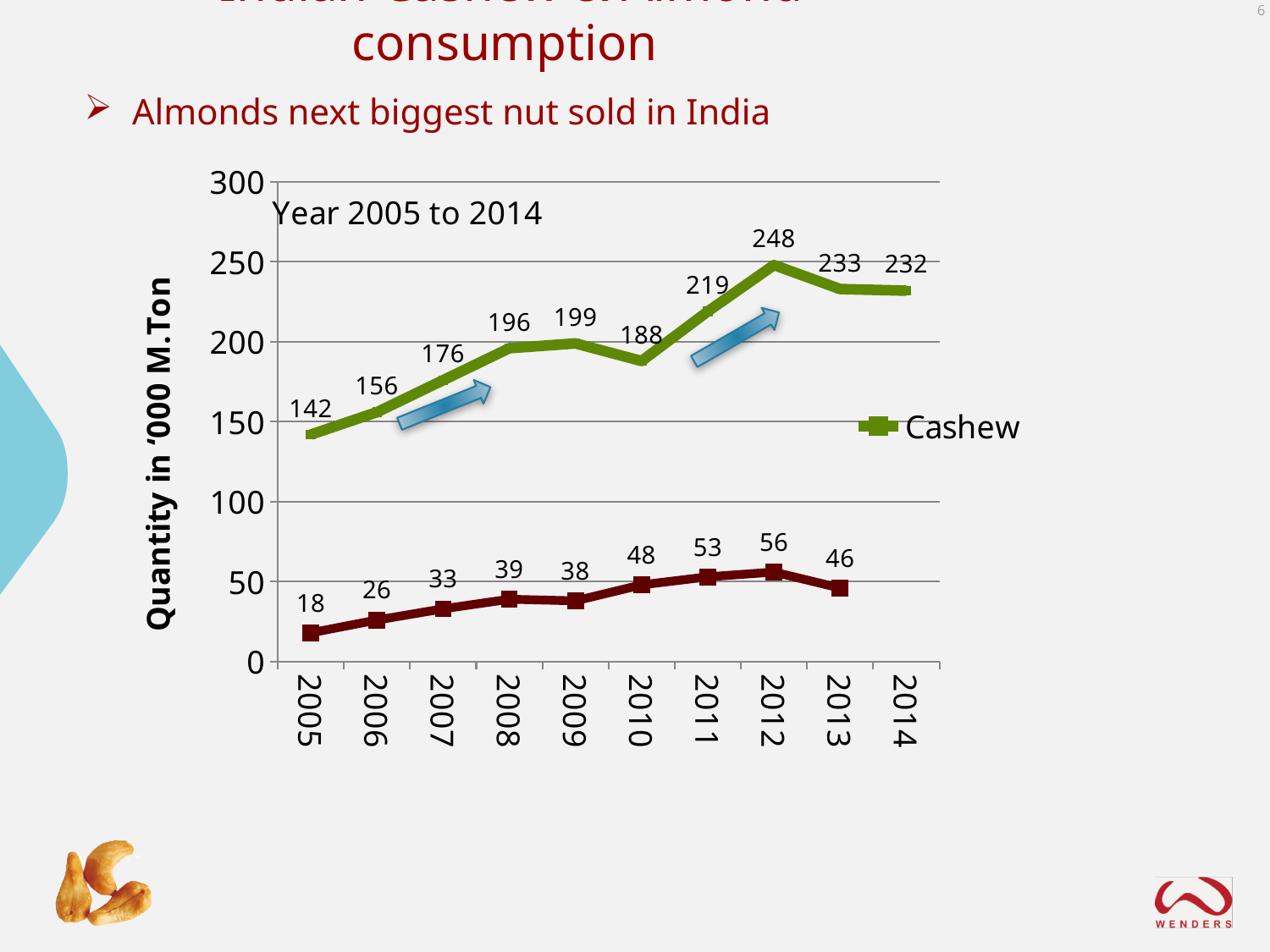
Which is larger, the Cashew value for 2008 or for 2009? 2009 What is the Cashew value for 2005? 142 In which year is the Cashew value highest? 2012 What kind of chart is shown on the slide? Line chart What is the Cashew value for 2012? 248 Which series name is listed in the chart legend? Cashew What is the y-axis title of the chart? Quantity in '000 M.Ton How many years are shown on the x axis? 10 Does the Cashew line rise or fall from 2005 to 2008? Rise What is the Cashew value for 2010? 188 In which year is the Cashew value lowest? 2005 What is the difference between the Cashew values for 2012 and 2005? 106